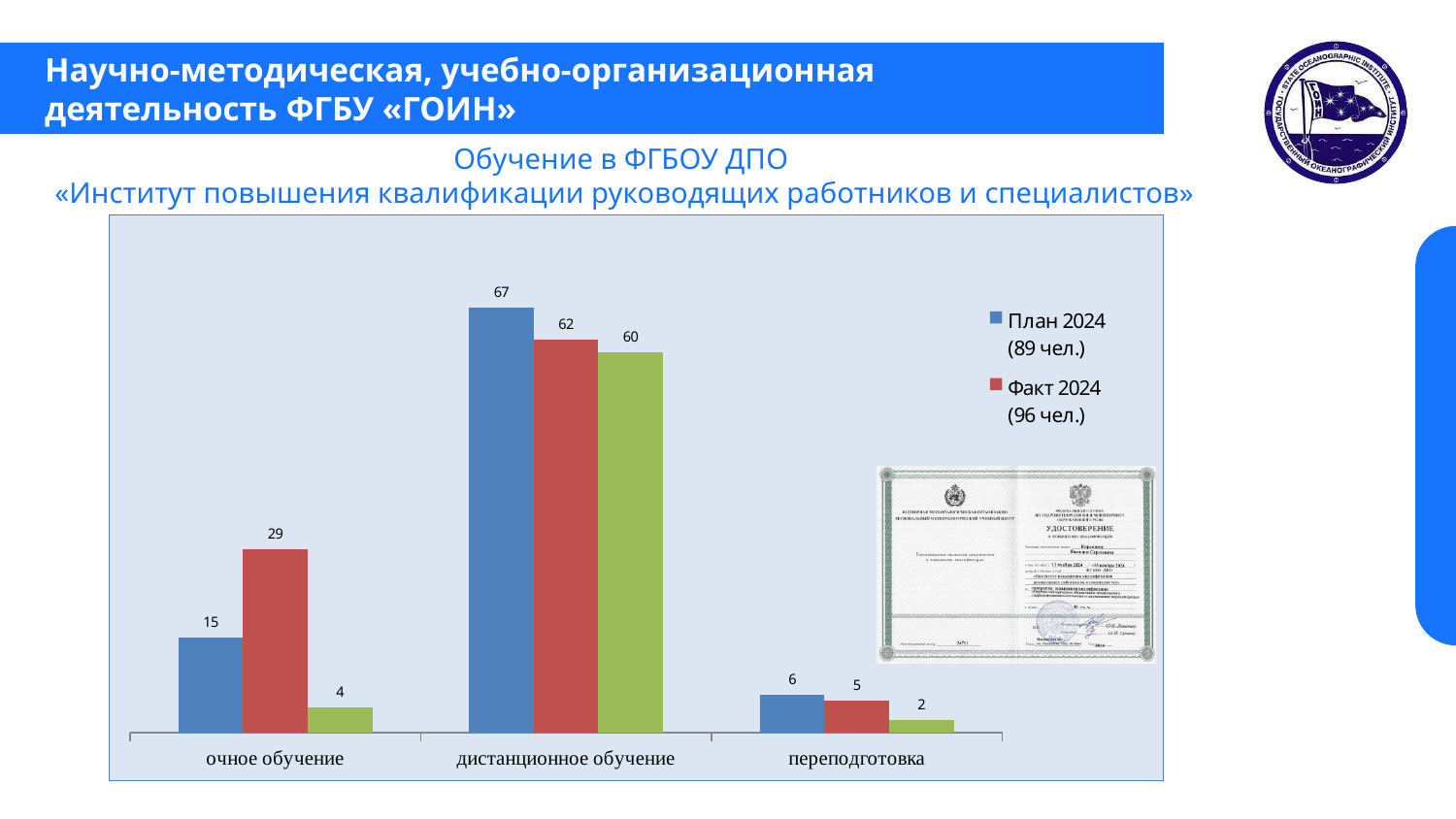
How many series does the chart legend list? 2 What is the План 2024 value for очное обучение? 15 For дистанционное обучение, what is the difference between the План 2024 and Факт 2024 values? 5 Which category has the lowest Факт 2024 value? переподготовка For очное обучение, which is larger: План 2024 or Факт 2024? Факт 2024 What is the Факт 2024 value for переподготовка? 5 What is the Факт 2024 value for дистанционное обучение? 62 What type of chart is shown on the slide? bar chart For очное обучение, how much larger is the Факт 2024 value than the План 2024 value? 14 How many categories are shown on the x axis of the chart? 3 According to the legend, how many people does Факт 2024 correspond to in total? 96 чел. Which category has the highest План 2024 value? дистанционное обучение